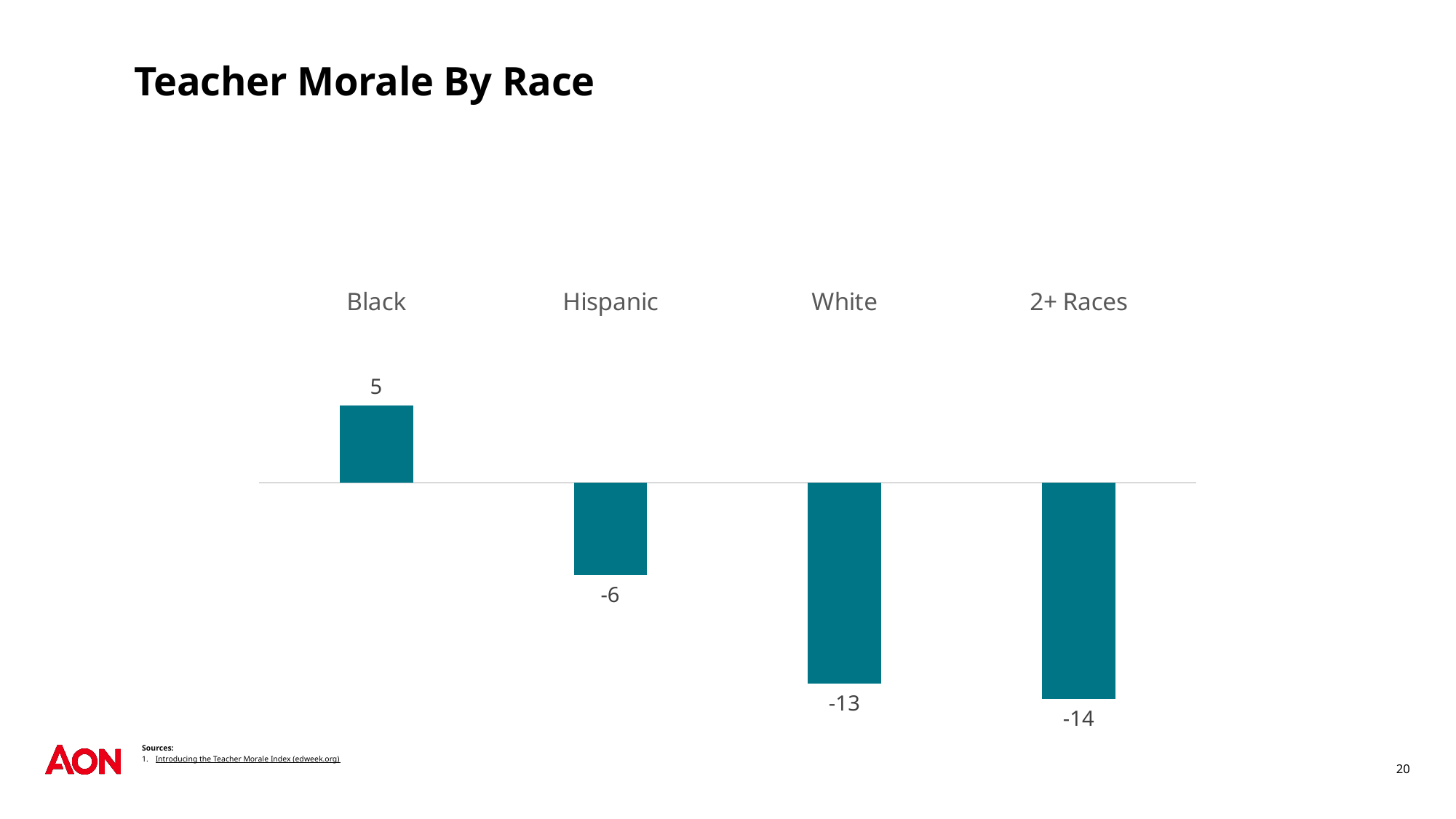
Which race category has the lowest teacher morale value? 2+ Races What is the teacher morale value for Black teachers? 5 What is the difference between the teacher morale values for Black and White teachers? 18 What is the title of the slide? Teacher Morale By Race What is the teacher morale value for teachers of 2+ Races? -14 How many race categories are shown in the chart? 4 Which race category has the highest teacher morale value? Black What is the difference between the teacher morale values for Hispanic and 2+ Races teachers? 8 What kind of chart is shown on the slide? Bar chart What is the teacher morale value for White teachers? -13 Which has a higher teacher morale value, Hispanic or White? Hispanic What is the teacher morale value for Hispanic teachers? -6